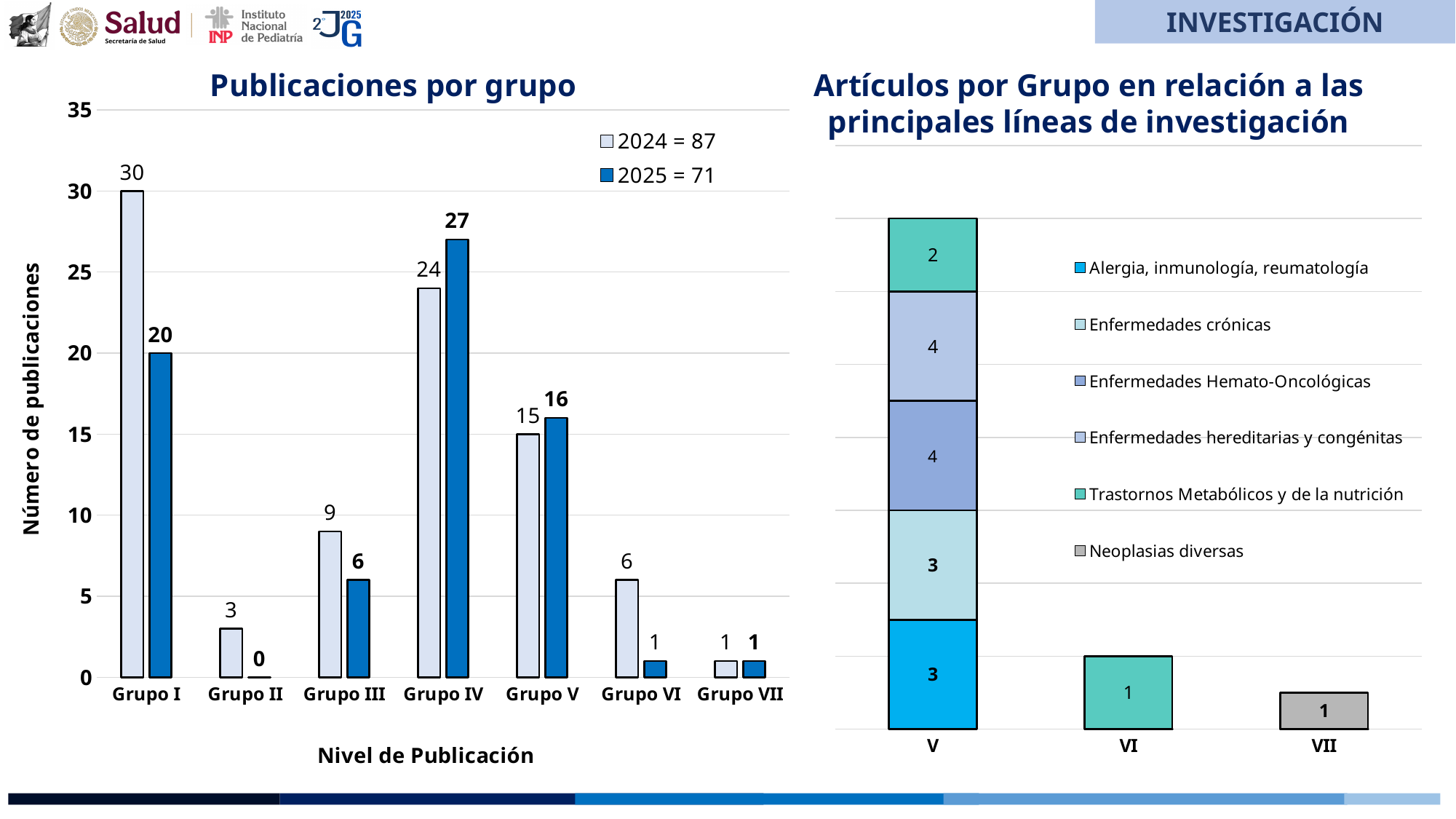
What type of chart is 'Publicaciones por grupo'? Bar chart In the 'Publicaciones por grupo' chart, how many groups are shown on the x axis? 7 In the 'Artículos por Grupo en relación a las principales líneas de investigación' chart, what is the total of the stacked bar for V? 16 In the 'Publicaciones por grupo' chart, what is the difference between the 2024 and 2025 values for Grupo I? 10 In the 'Publicaciones por grupo' chart, which is larger for Grupo V: the 2024 value or the 2025 value? 2025 In the 'Artículos por Grupo en relación a las principales líneas de investigación' chart, what is the value for Enfermedades Hemato-Oncológicas in group V? 4 In the 'Artículos por Grupo en relación a las principales líneas de investigación' chart, how many entries does the legend list? 6 In the 'Publicaciones por grupo' chart, which group had the lowest number of publications in 2025? Grupo II In the 'Publicaciones por grupo' chart, which group had the highest number of publications in 2025? Grupo IV In the 'Publicaciones por grupo' chart, how many series does the legend list? 2 In the 'Publicaciones por grupo' chart, how many publications did Grupo I have in 2024? 30 In the 'Publicaciones por grupo' chart, how many publications did Grupo IV have in 2025? 27